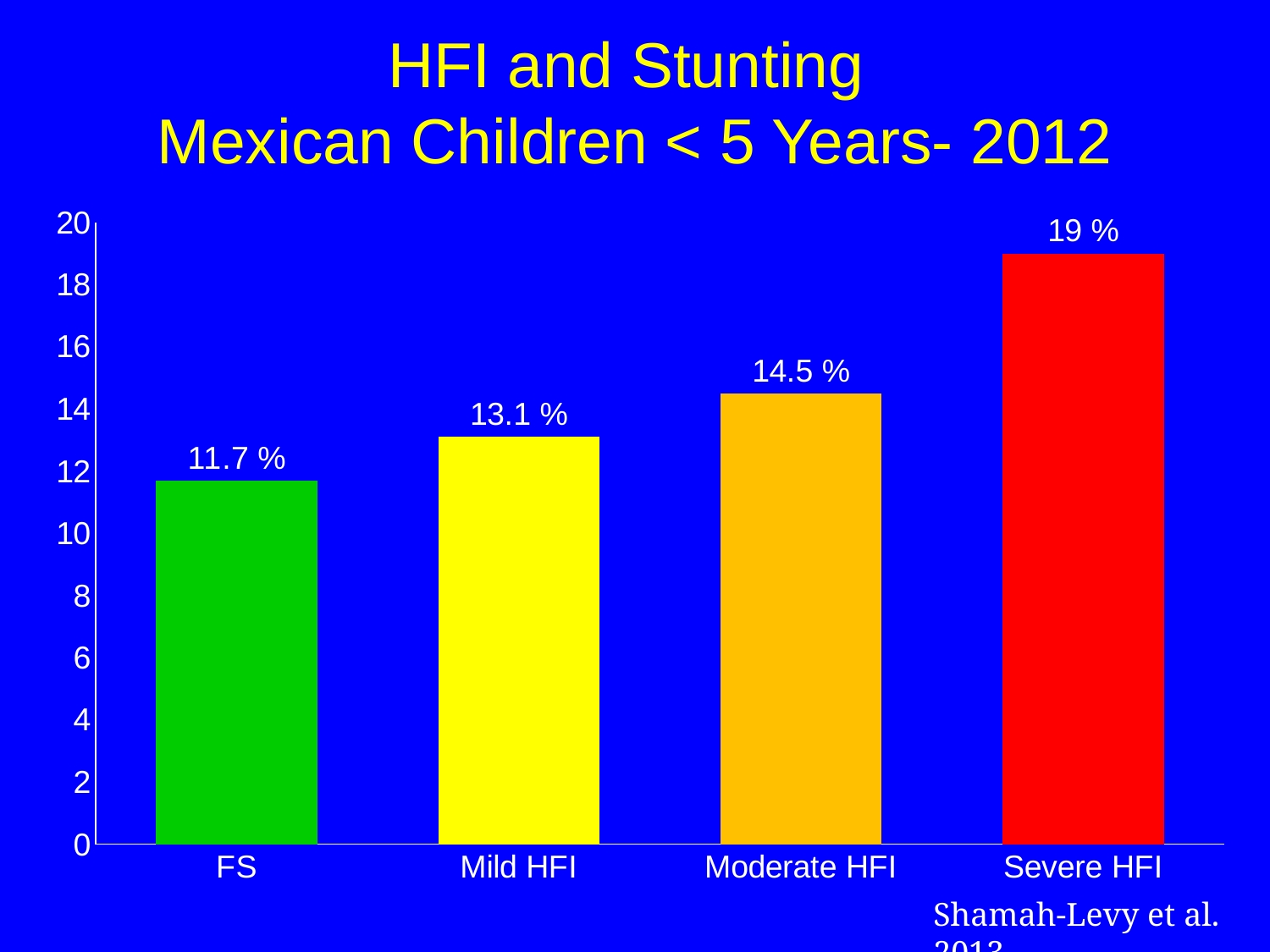
Which category has the highest stunting value? Severe HFI Which category has the lowest stunting value? FS How many categories are shown on the x axis? 4 Do the values rise or fall from FS to Severe HFI along the x axis? Rise What is the difference between the Moderate HFI and Mild HFI values? 1.4 % What is the stunting value for FS? 11.7 % What kind of chart is shown on the slide? Bar chart What is the stunting value for Mild HFI? 13.1 % What is the difference between the Severe HFI and FS values? 7.3 % Which is larger, the value for Mild HFI or the value for Moderate HFI? Moderate HFI What is the stunting value for Severe HFI? 19 % What is the stunting value for Moderate HFI? 14.5 %